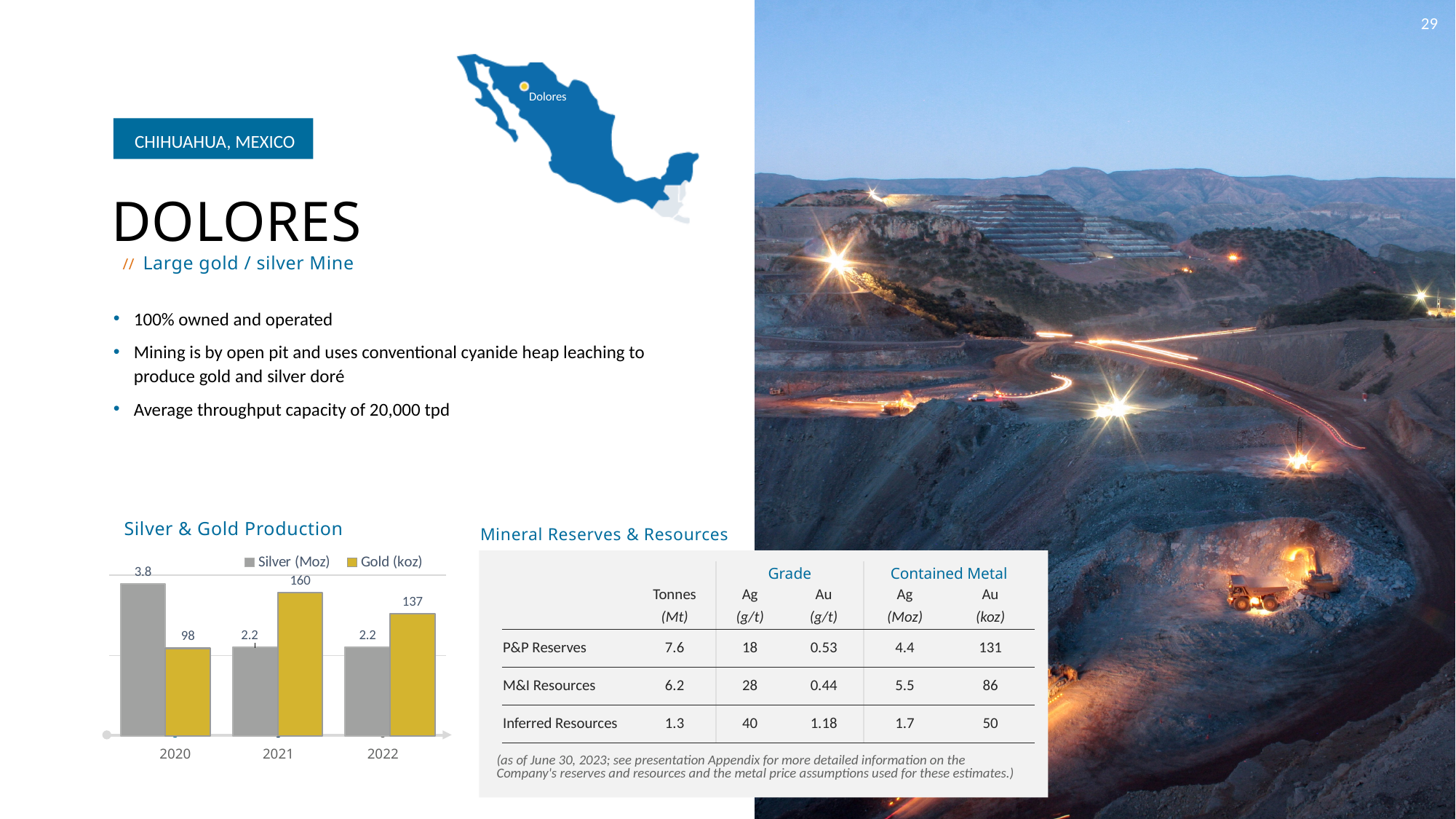
What was the silver production (Moz) in 2022 according to the Silver & Gold Production chart? 2.2 Which year had higher gold production in the Silver & Gold Production chart, 2021 or 2022? 2021 In which year was silver production highest in the Silver & Gold Production chart? 2020 What was the gold production (koz) in 2022 according to the Silver & Gold Production chart? 137 What was the silver production (Moz) in 2020 according to the Silver & Gold Production chart? 3.8 In which year was gold production highest in the Silver & Gold Production chart? 2021 By how many koz did gold production in 2021 exceed gold production in 2020 in the Silver & Gold Production chart? 62 How many series does the legend of the Silver & Gold Production chart list? 2 What type of chart is the Silver & Gold Production chart? Bar chart What is the difference in silver production (Moz) between 2020 and 2021 in the Silver & Gold Production chart? 1.6 What was the gold production (koz) in 2021 according to the Silver & Gold Production chart? 160 In which year was gold production lowest in the Silver & Gold Production chart? 2020